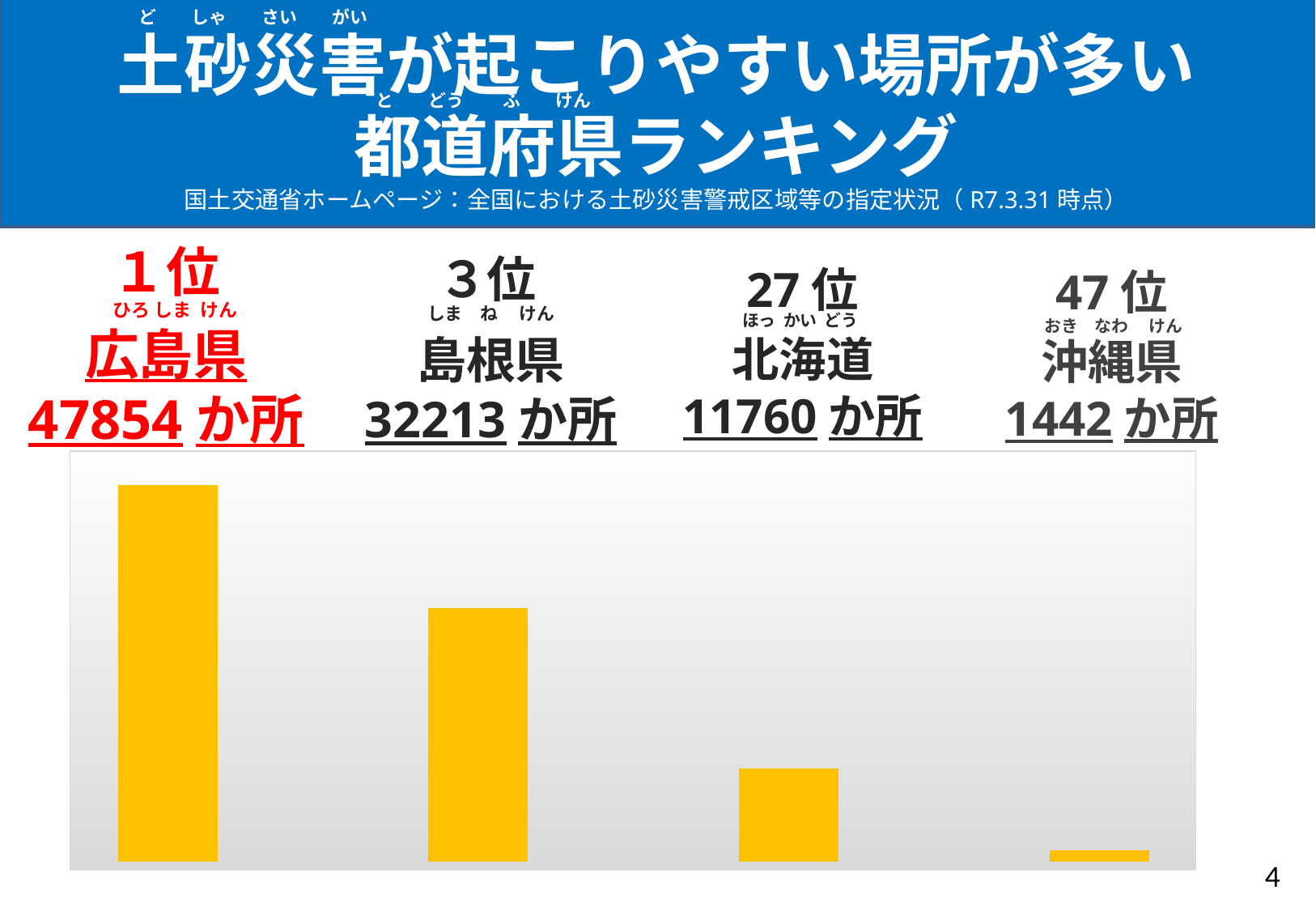
Which prefecture has the lowest bar in the chart? 沖縄県 Which is larger, the value for 島根県 or the value for 北海道? 島根県 What is the difference between the values for 広島県 and 島根県? 15641 What is the value shown for 島根県? 32213 か所 Which prefecture has the highest bar in the chart? 広島県 What kind of chart is shown on the slide? Bar chart What is the value shown for 広島県? 47854 か所 What is the value shown for 沖縄県? 1442 か所 Do the bar values rise or fall from left to right across the chart? Fall What is the difference between the values for 北海道 and 沖縄県? 10318 What is the value shown for 北海道? 11760 か所 How many bars are shown in the chart? 4